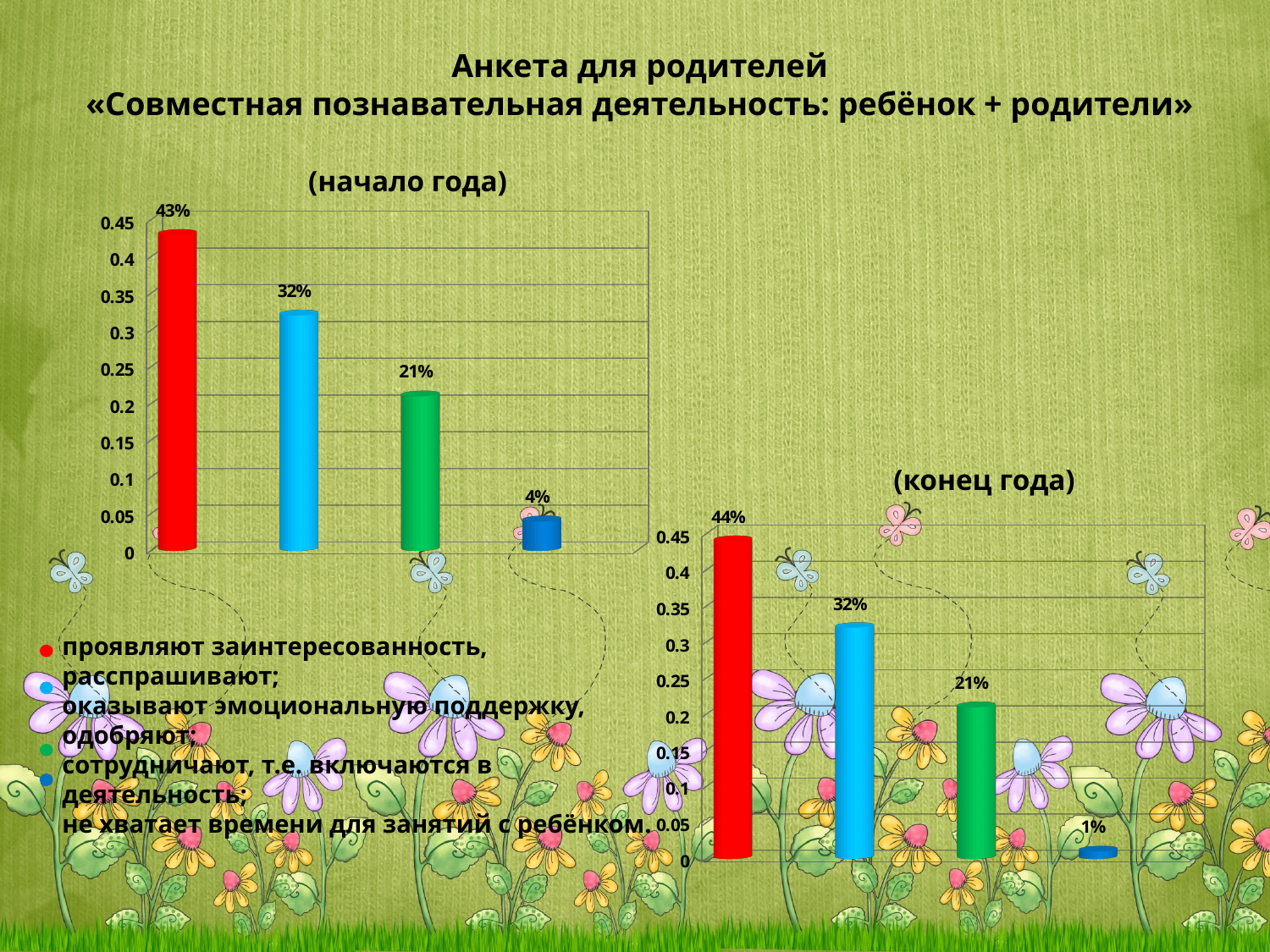
How many bars are shown in the chart titled «(конец года)»? 4 In the chart titled «(начало года)», what is the value of the red bar (проявляют заинтересованность, расспрашивают)? 43% In the chart titled «(конец года)», what is the value of the dark blue bar (не хватает времени для занятий с ребёнком)? 1% In the chart titled «(начало года)», what is the value of the dark blue bar (не хватает времени для занятий с ребёнком)? 4% Which is larger: the red bar in «(начало года)» or the red bar in «(конец года)»? the red bar in «(конец года)» (44%) In the chart titled «(начало года)», which bar has the highest value? the red bar (проявляют заинтересованность, расспрашивают), 43% In the chart titled «(конец года)», what is the value of the red bar (проявляют заинтересованность, расспрашивают)? 44% In the chart titled «(конец года)», what is the value of the green bar (сотрудничают, т.е. включаются в деятельность)? 21% In the chart titled «(начало года)», what is the difference between the red bar (43%) and the light blue bar (32%)? 11% In the chart titled «(конец года)», which bar has the lowest value? the dark blue bar (не хватает времени для занятий с ребёнком), 1% What type of chart is used for «(начало года)»? bar chart What is the difference between the dark blue bar in «(начало года)» (4%) and the dark blue bar in «(конец года)» (1%)? 3%